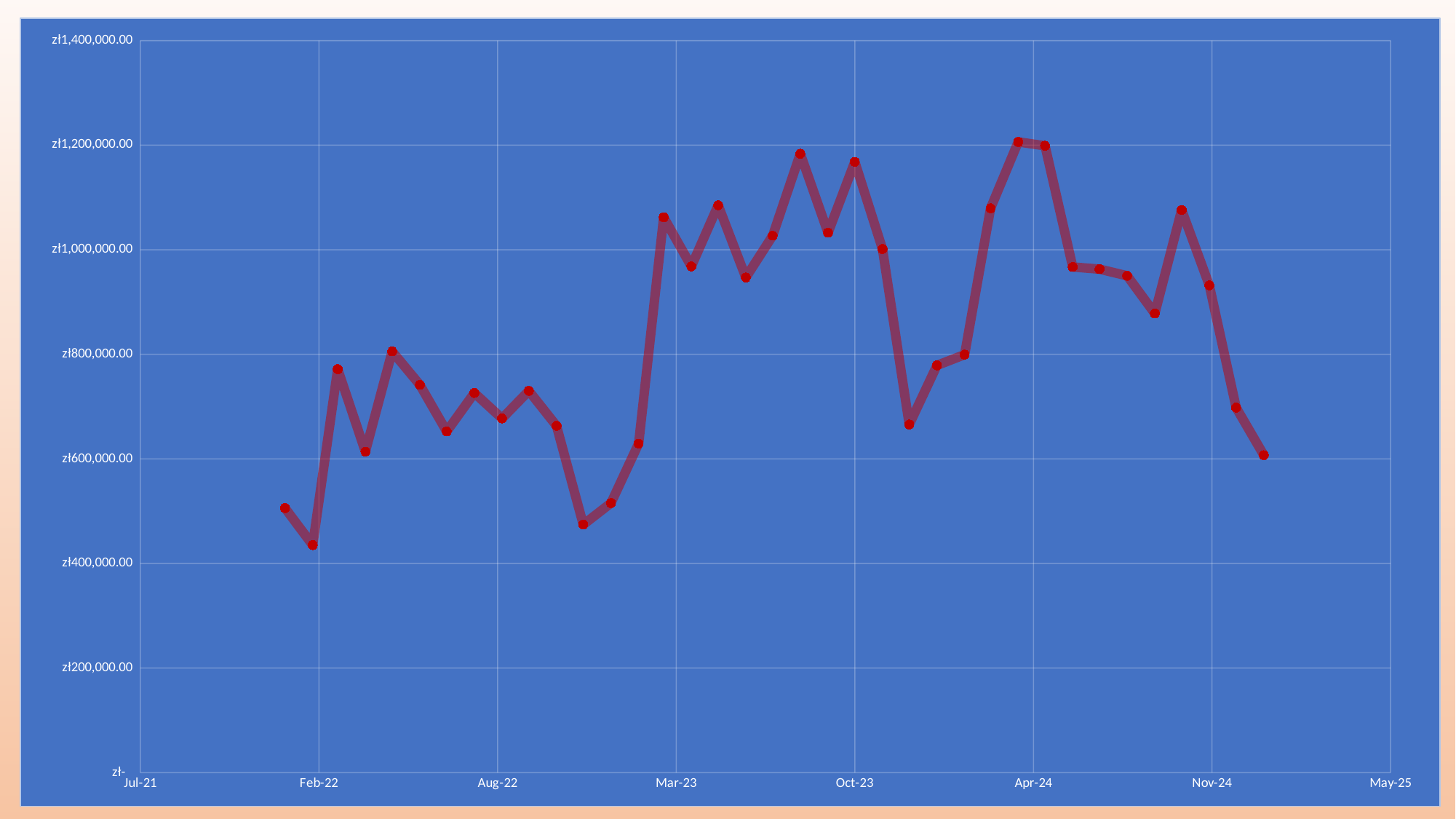
Do the values rise or fall over the last three points of the line? fall Is the lowest value on the chart greater or less than zł600,000.00? less What kind of chart is shown on the slide? line chart Which is larger, the value at Apr-24 or the value at Aug-22? Apr-24 Is the value at Oct-23 greater or less than zł1,000,000.00? greater Which is larger, the value at Oct-23 or the value at Nov-24? Oct-23 Is the value at Aug-22 greater or less than zł800,000.00? less What is the highest value shown on the y axis? zł1,400,000.00 What is the first label on the x axis? Jul-21 How many data points are plotted on the line? 37